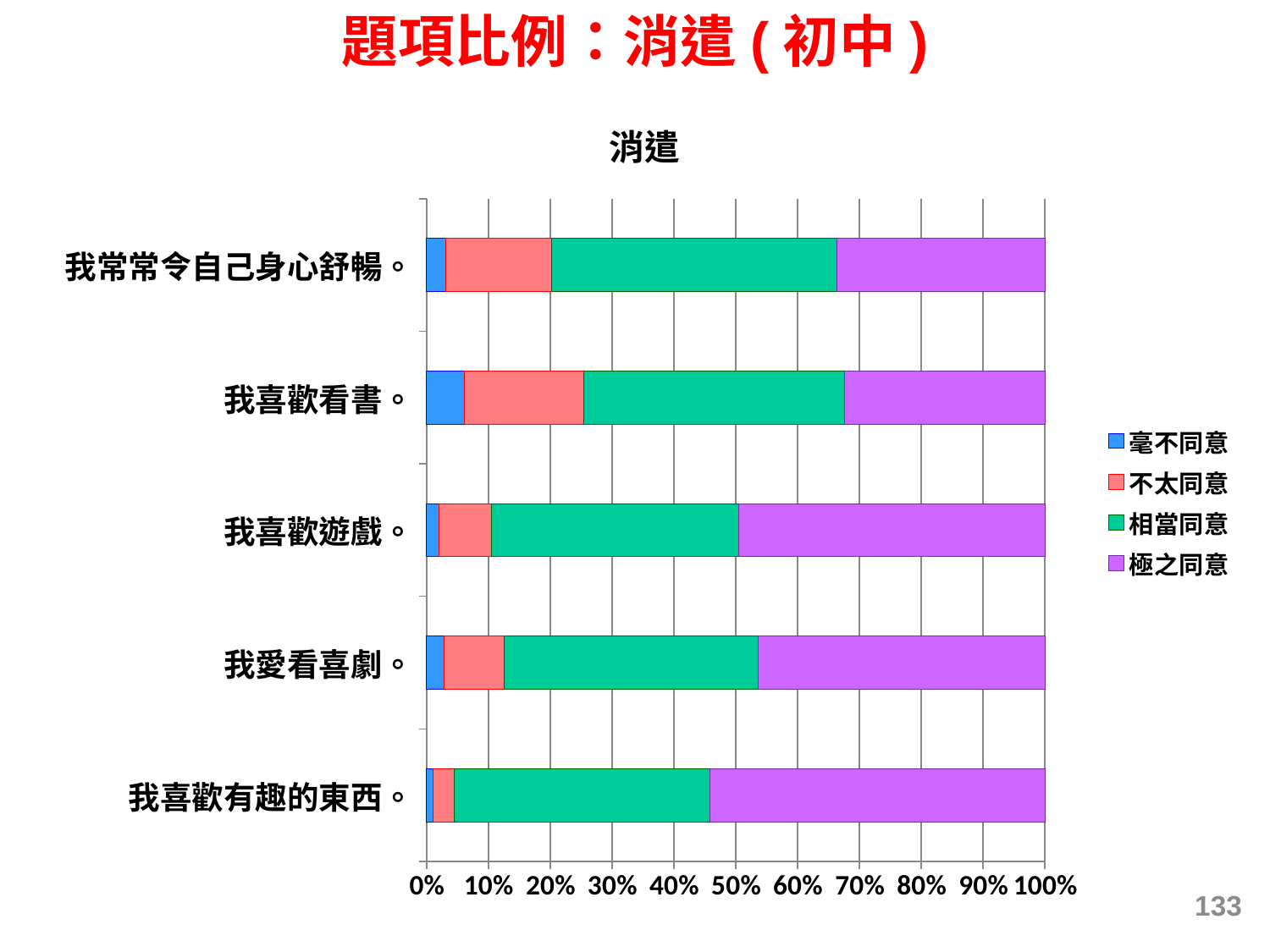
Which legend entry is shown in purple? 極之同意 What is the total of the stacked bar for 我喜歡遊戲? 100% How many series does the legend of the 消遣 chart list? 4 Is the 極之同意 share for 我喜歡看書 greater or less than 40%? less Is the 極之同意 share for 我喜歡有趣的東西 greater or less than 50%? greater What is the title of the chart on the slide? 消遣 Is the 不太同意 share for 我喜歡看書 greater or less than 10%? greater Which statement has the largest 極之同意 segment? 我喜歡有趣的東西 What kind of chart is shown on the slide? Stacked bar chart Which has a larger 極之同意 share: 我喜歡遊戲 or 我喜歡看書? 我喜歡遊戲 Which statement has the largest 毫不同意 segment? 我喜歡看書 How many statements (categories) are plotted in the 消遣 chart? 5